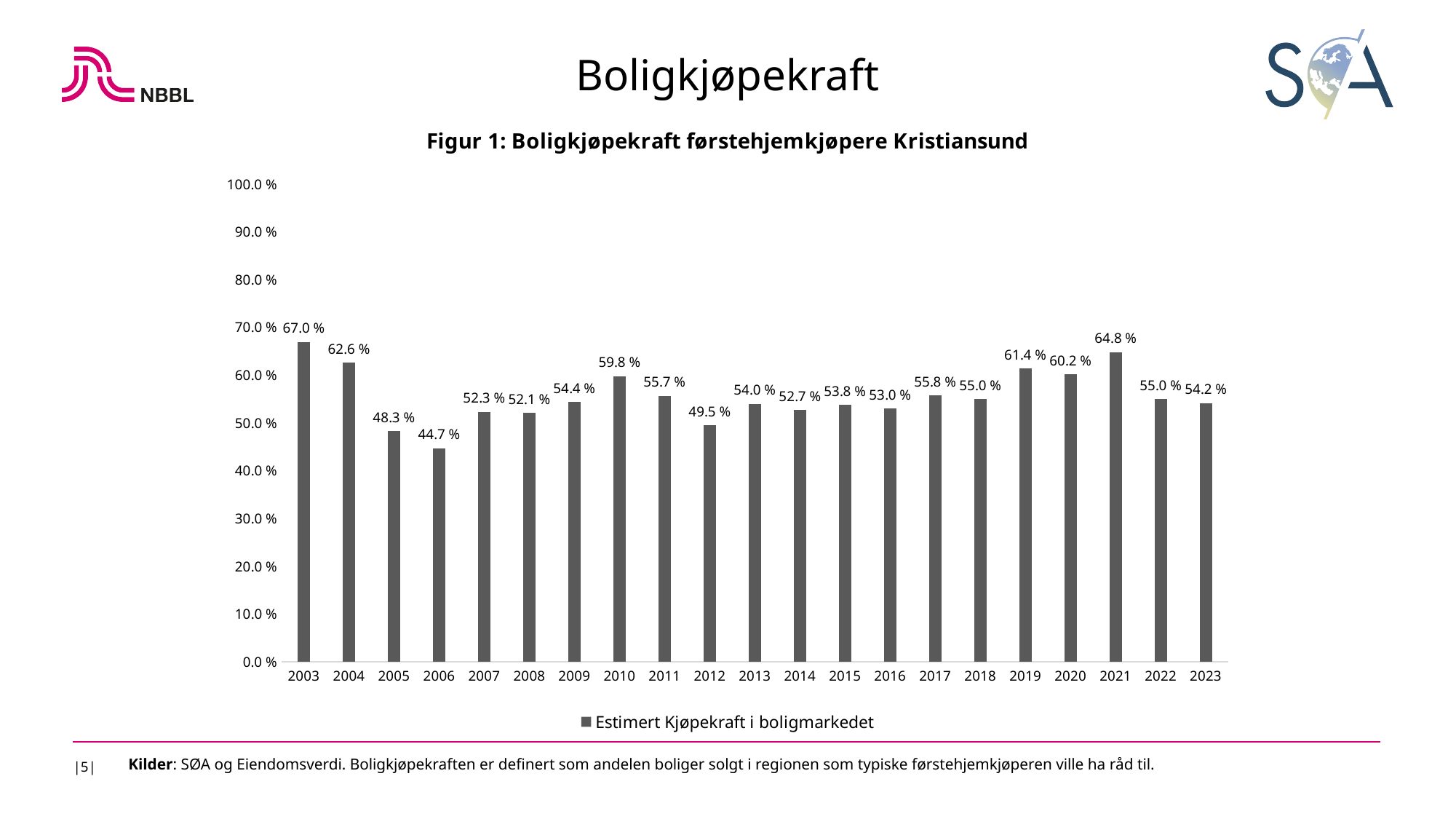
What is the value for 2021? 64.8 % Which is larger, the value for 2019 or the value for 2020? 2019 What is the value for 2003? 67.0 % What is the value for 2012? 49.5 % Which year has the lowest value? 2006 How many years are shown on the x axis? 21 What is the title of the chart? Figur 1: Boligkjøpekraft førstehjemkjøpere Kristiansund What kind of chart is this? bar chart Which year has the highest value? 2003 What is the difference between the values for 2003 and 2006? 22.3 % How many series does the legend list? 1 Is the value for 2010 greater or less than 50.0 %? greater